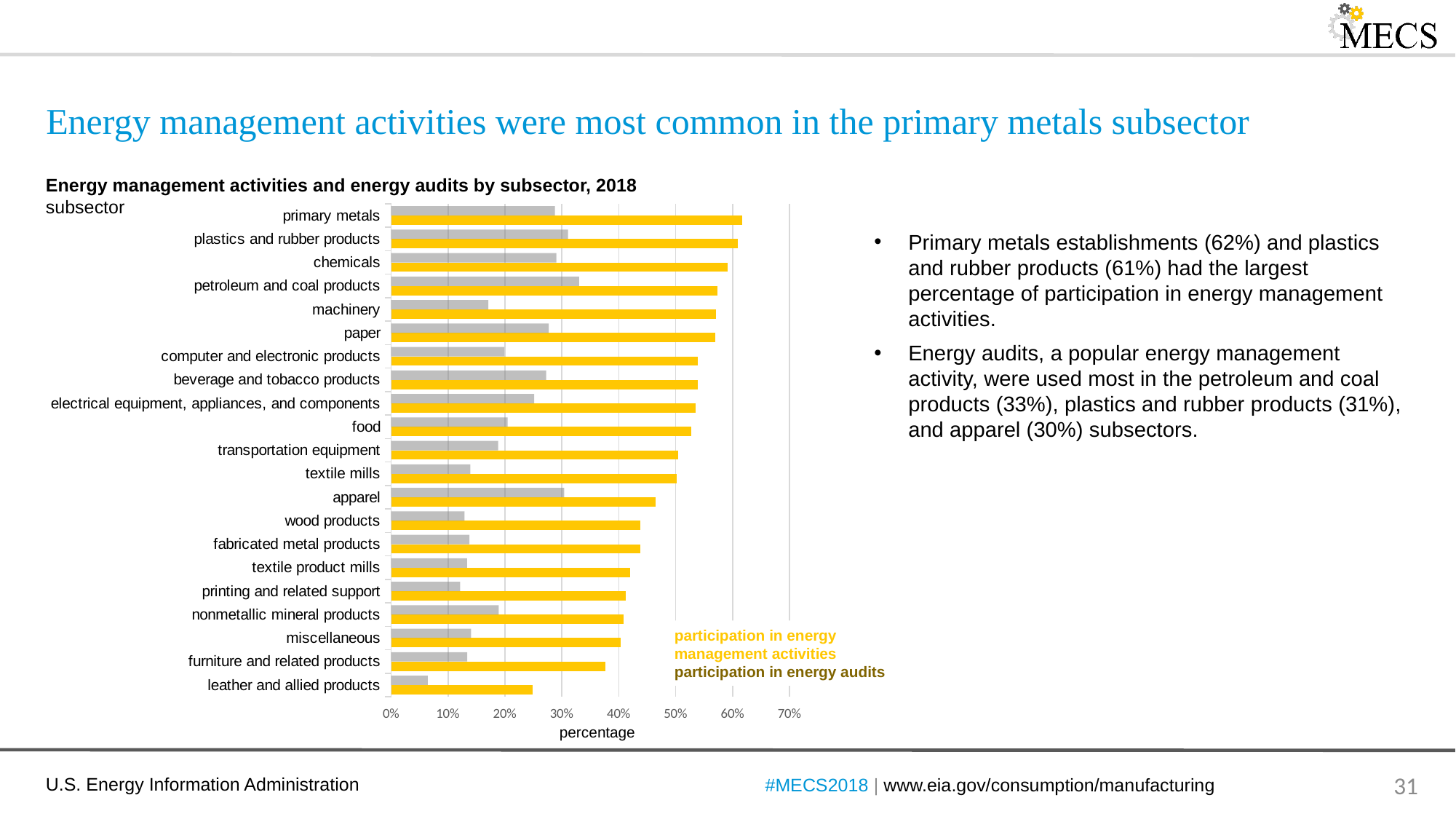
Which subsector has the lowest participation in energy management activities? leather and allied products How many subsectors are listed on the chart? 21 Which subsector has the highest participation in energy management activities? primary metals Which is larger for apparel: participation in energy management activities or participation in energy audits? participation in energy management activities Which subsector has the highest participation in energy audits? petroleum and coal products What is the participation in energy audits for petroleum and coal products? 33% What kind of chart is shown on the slide? bar chart How many series does the chart's legend list? 2 What is the difference in participation in energy management activities between primary metals and plastics and rubber products? 1 percentage point Is the participation in energy audits for machinery greater or less than 20%? less Which subsector has the lowest participation in energy audits? leather and allied products What is the participation in energy management activities for primary metals? 62%